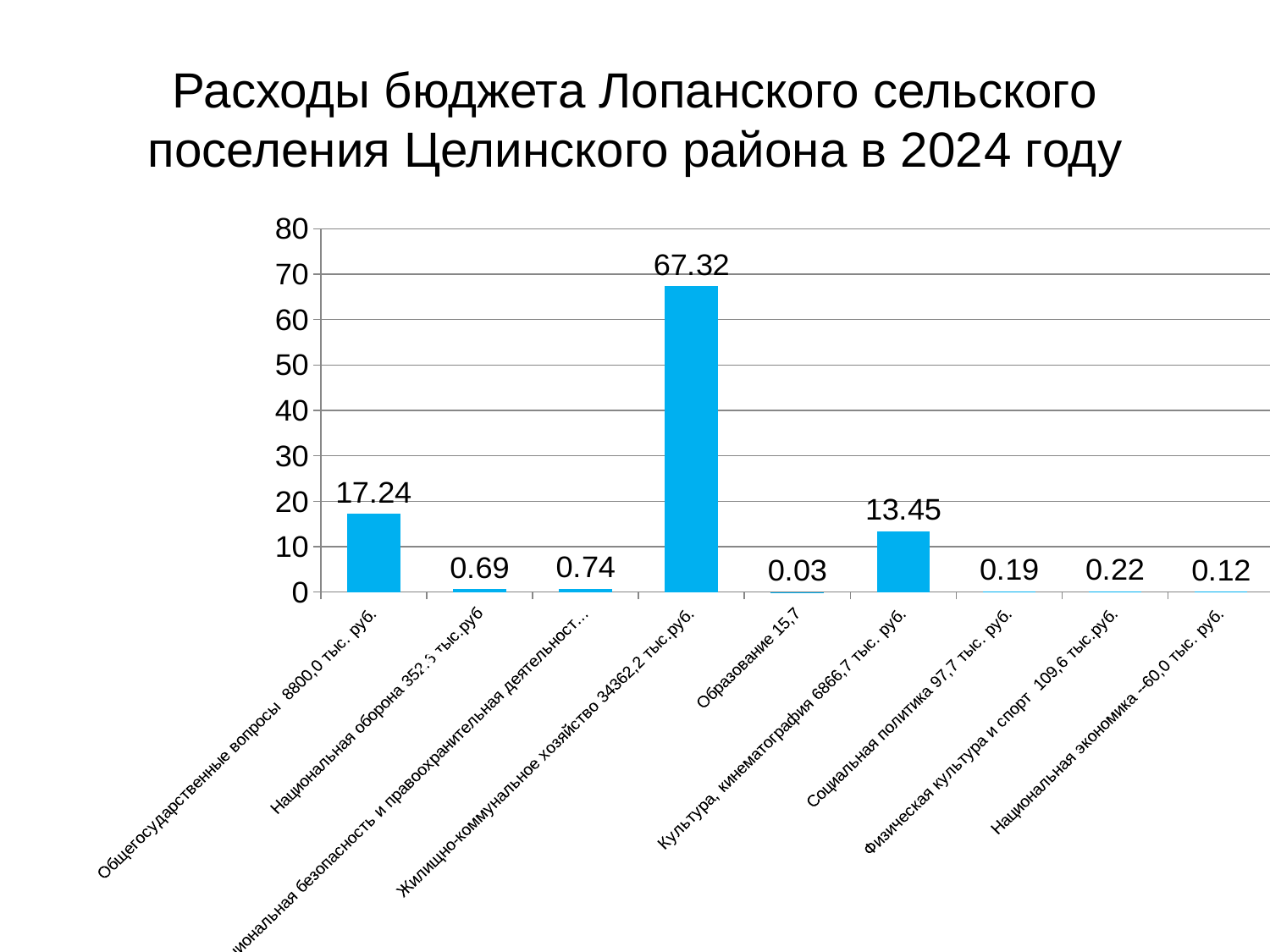
Which is larger, the value for Общегосударственные вопросы or the value for Культура, кинематография? Общегосударственные вопросы What is the value shown for Общегосударственные вопросы? 17.24 How many categories are shown in the chart? 9 What is the value shown for Жилищно-коммунальное хозяйство? 67.32 What is the title of the chart on the slide? Расходы бюджета Лопанского сельского поселения Целинского района в 2024 году What is the value shown for Культура, кинематография? 13.45 Which category has the lowest value? Образование What is the value shown for Физическая культура и спорт? 0.22 What is the difference between the values for Жилищно-коммунальное хозяйство and Общегосударственные вопросы? 50.08 Which category has the highest value? Жилищно-коммунальное хозяйство What is the value shown for Образование? 0.03 What kind of chart is shown on the slide? Bar chart